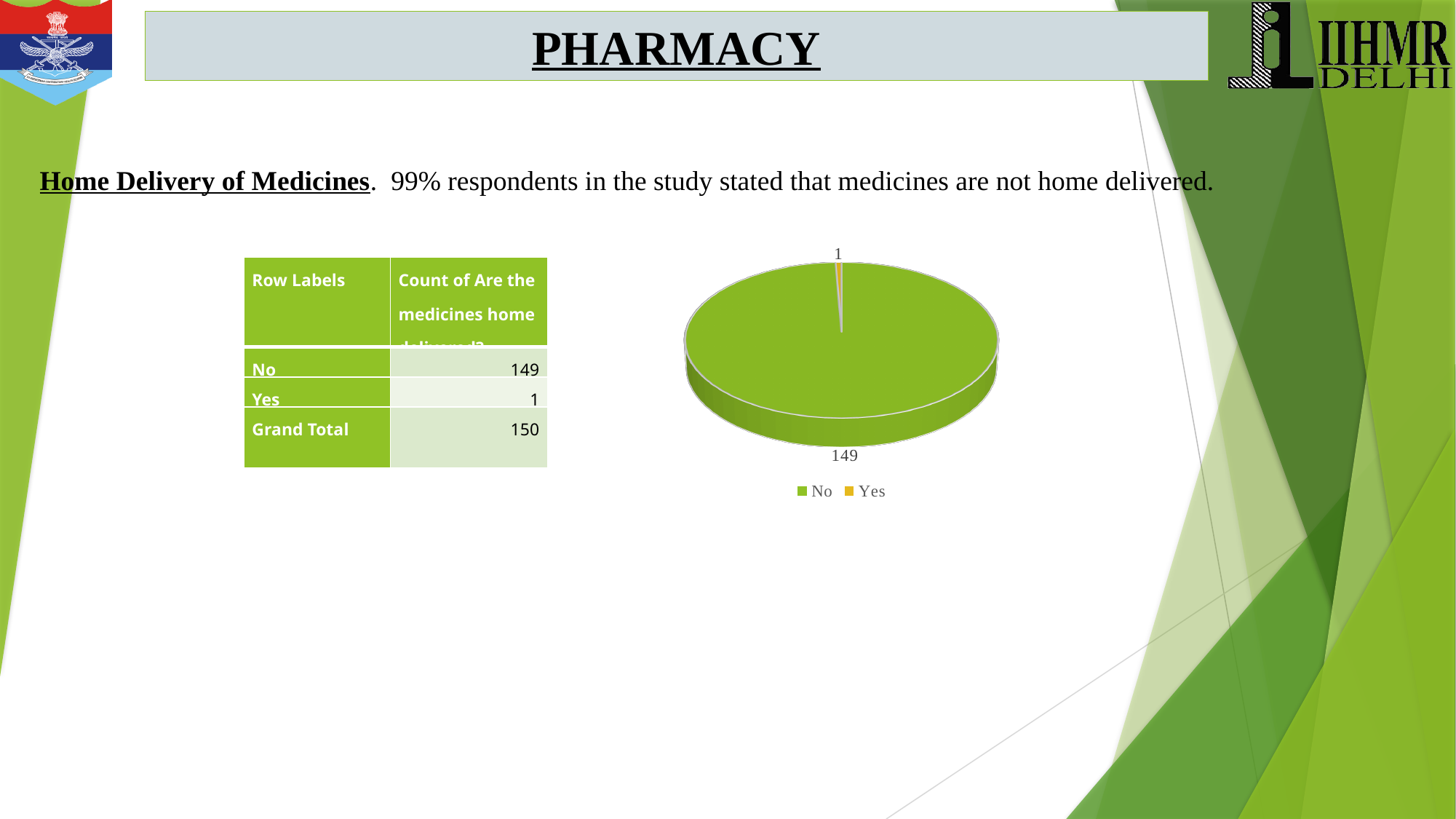
How many entries does the pie chart legend list? 2 What is the value for the No slice in the pie chart? 149 What is the value for the Yes slice in the pie chart? 1 What colour is the No slice in the pie chart? Green What kind of chart is shown on the slide? Pie chart What is the difference between the No and Yes values in the pie chart? 148 Which slice of the pie chart is the largest? No Which slice of the pie chart is the smallest? Yes What is the total of all slices in the pie chart? 150 What colour is the Yes slice in the pie chart? Orange Which is larger in the pie chart, No or Yes? No How many slices does the pie chart have? 2